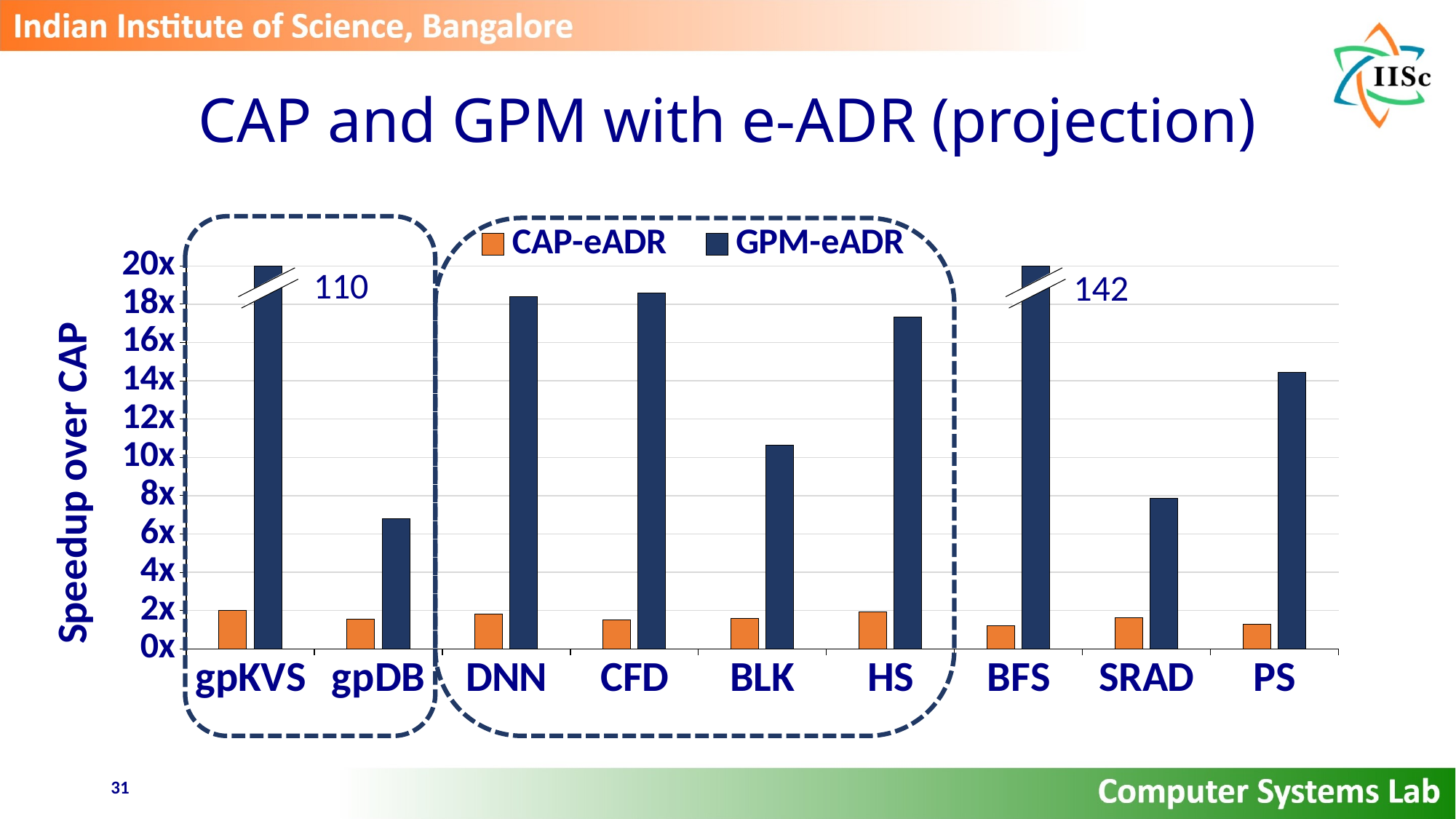
How many series does the legend list? 2 What is the difference between the annotated GPM-eADR speedups for BFS and gpKVS? 32 How many categories are shown along the x axis? 9 What kind of chart is shown on the slide? bar chart What is the GPM-eADR speedup for BFS, as annotated on the chart? 142 What is the GPM-eADR speedup for gpKVS, as annotated on the chart? 110 Is the GPM-eADR value for DNN greater or less than 16x? greater Which has the larger GPM-eADR speedup, CFD or BLK? CFD Which category has the highest GPM-eADR speedup? BFS Is the GPM-eADR value for gpDB greater or less than 8x? less What is the label of the y axis? Speedup over CAP Is the GPM-eADR value for SRAD greater or less than 10x? less